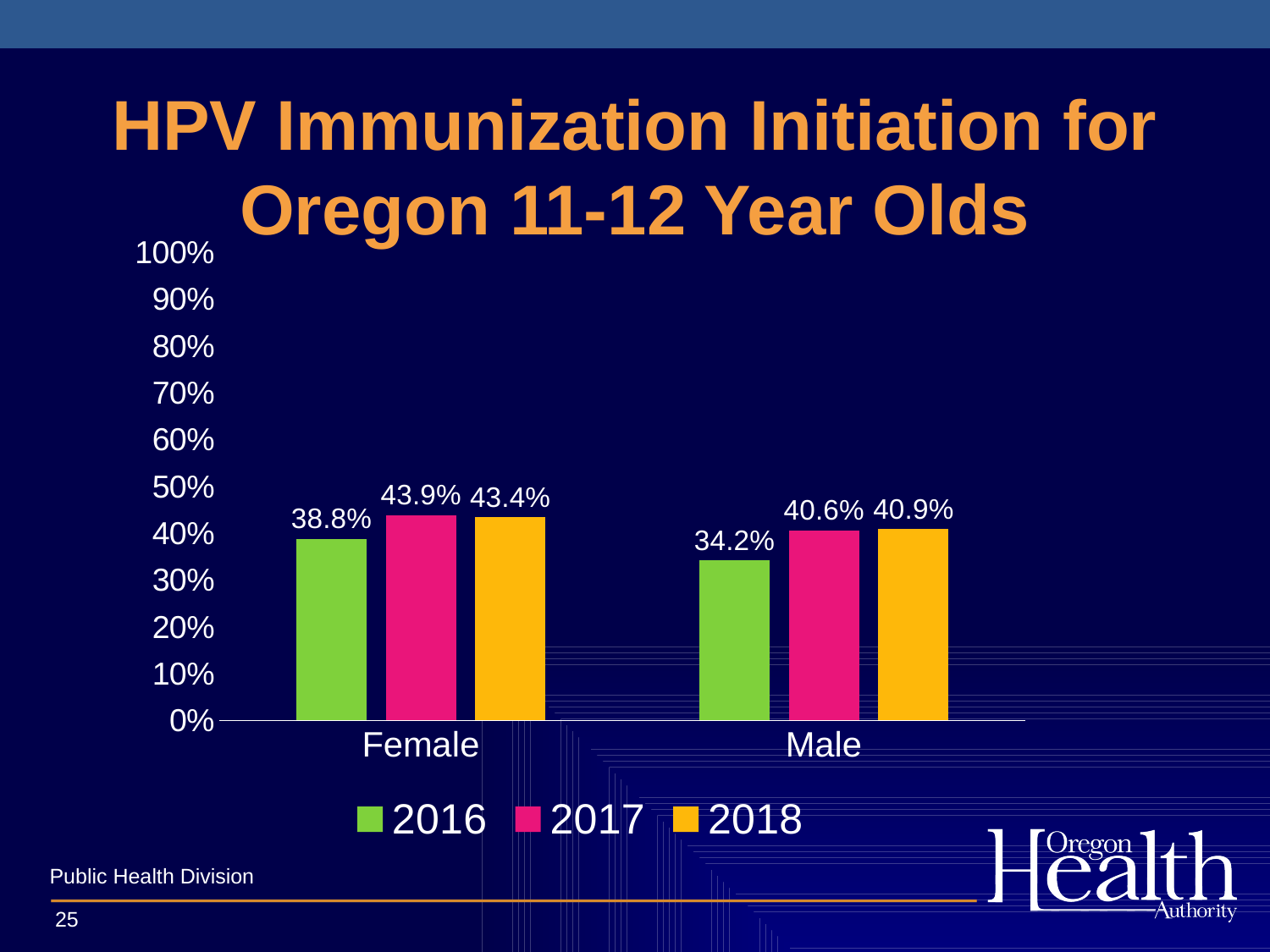
What is the value for Male in 2016? 34.2% What is the difference between the Female and Male values in 2016? 4.6% What is the value for Female in 2017? 43.9% Which colour represents 2017 in the legend? Pink What is the HPV immunization initiation rate for Male in 2018? 40.9% Which category has the lowest value in 2016? Male What kind of chart is shown on the slide? Bar chart How many series does the legend list? 3 Which is larger, the Female value in 2018 or the Male value in 2018? Female What is the HPV immunization initiation rate for Female in 2016? 38.8% What is the difference between the 2018 and 2016 values for Male? 6.7% Which year has the highest value for Female? 2017